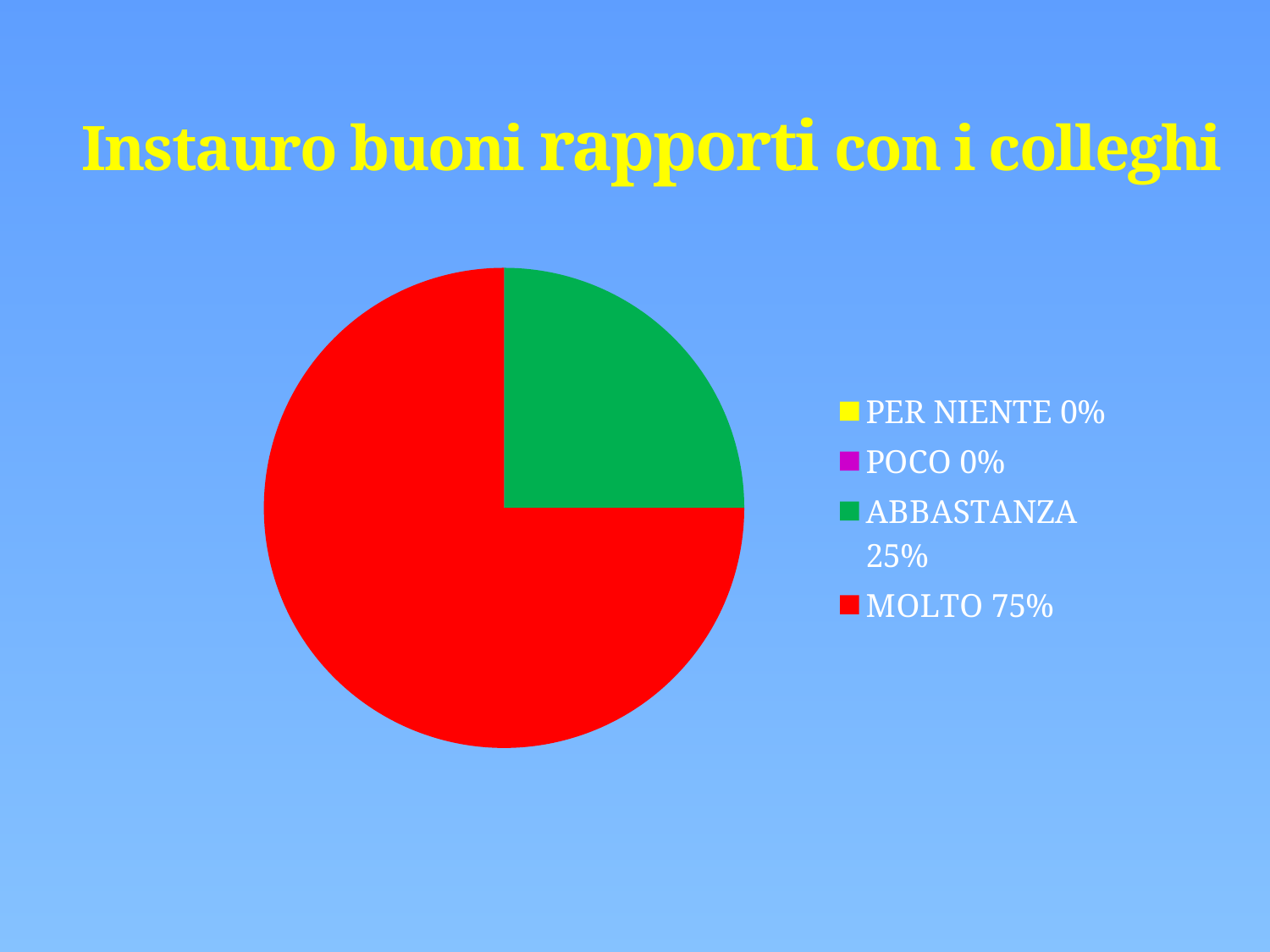
What is the difference between the MOLTO and ABBASTANZA shares? 50% Which is larger, the share for MOLTO or the share for ABBASTANZA? MOLTO Is the share for MOLTO greater or less than 50%? greater What is the value for POCO? 0% What is the value for PER NIENTE? 0% What share of the pie does MOLTO represent? 75% What colour is the MOLTO slice? red Which category has the largest share of the pie? MOLTO What share of the pie does ABBASTANZA represent? 25% What is the title of the chart? Instauro buoni rapporti con i colleghi What kind of chart is shown on the slide? pie chart How many categories does the legend list? 4